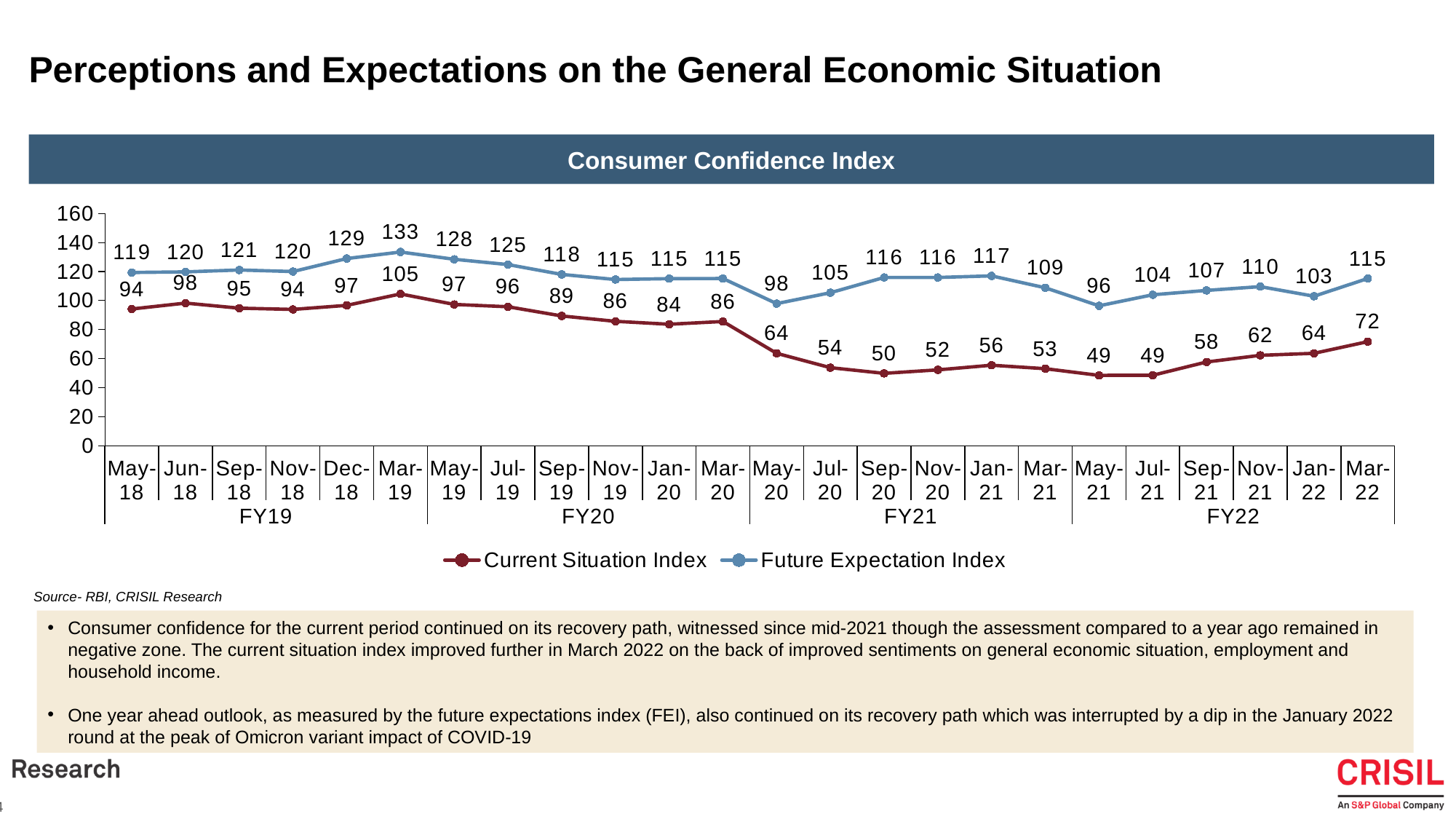
Does the Current Situation Index rise or fall from May-21 to Mar-22? Rise In which month does the Future Expectation Index reach its lowest value? May-21 What is the Current Situation Index value for Mar-22? 72 What is the difference between the Future Expectation Index and the Current Situation Index in Mar-22? 43 How many series does the legend list? 2 In which month does the Current Situation Index reach its highest value? Mar-19 How many data points are plotted for each series? 24 What type of chart is shown? Line chart What is the Current Situation Index value for Sep-20? 50 Which is larger, the Current Situation Index in May-20 or in Jul-20? May-20 In which month does the Future Expectation Index reach its highest value? Mar-19 What is the Future Expectation Index value for Mar-19? 133